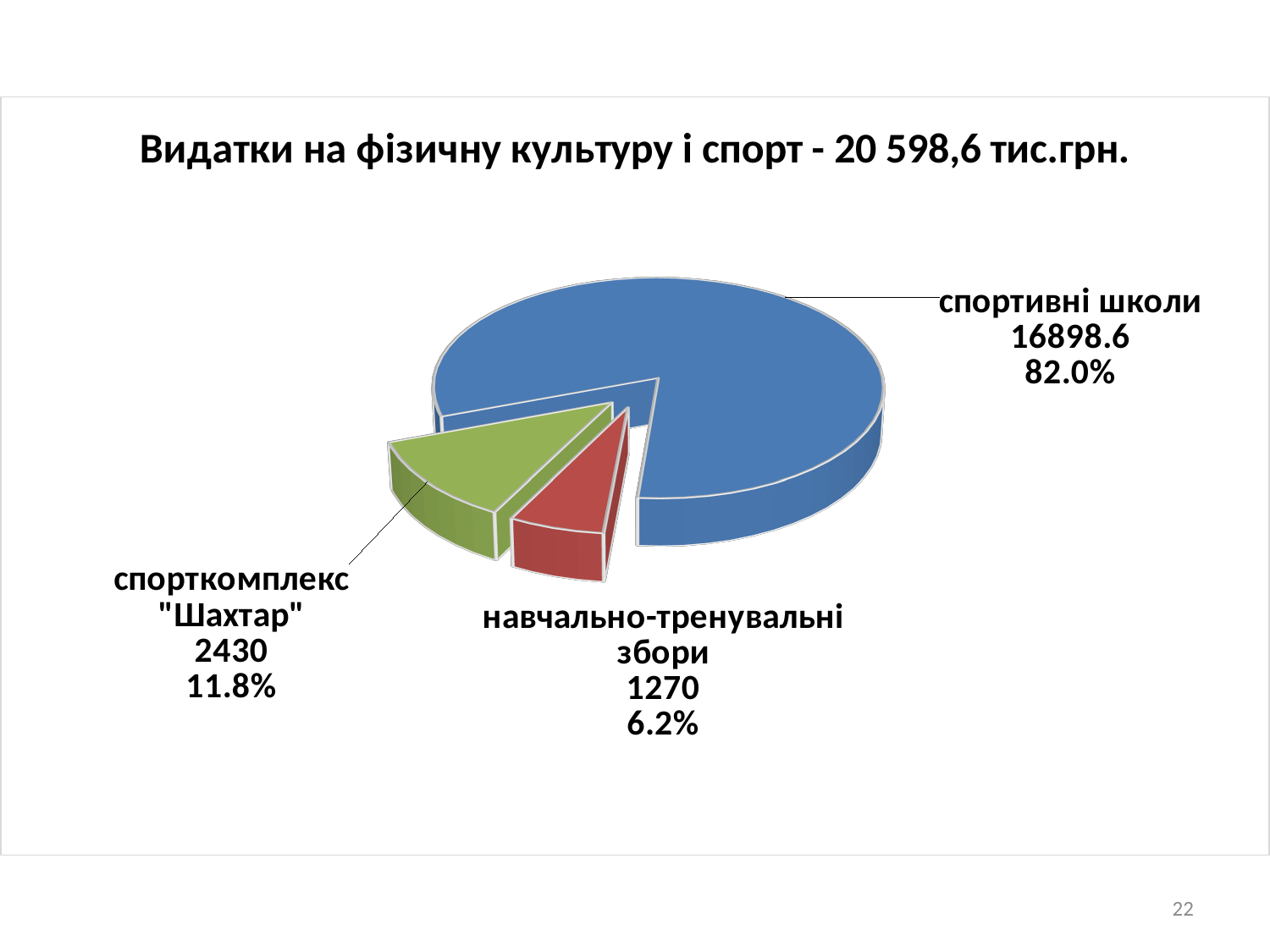
What is the title of the chart? Видатки на фізичну культуру і спорт - 20 598,6 тис.грн. What is the value for спорткомплекс "Шахтар"? 2430 What type of chart is shown on the slide? pie chart What is the value for навчально-тренувальні збори? 1270 What share of the pie does спорткомплекс "Шахтар" represent? 11.8% Which category has the largest slice? спортивні школи What is the value for спортивні школи? 16898.6 What share of the pie does навчально-тренувальні збори represent? 6.2% What is the difference between the values for спорткомплекс "Шахтар" and навчально-тренувальні збори? 1160 Which category has the smallest slice? навчально-тренувальні збори What share of the pie does спортивні школи represent? 82.0% How many slices does the pie chart have? 3